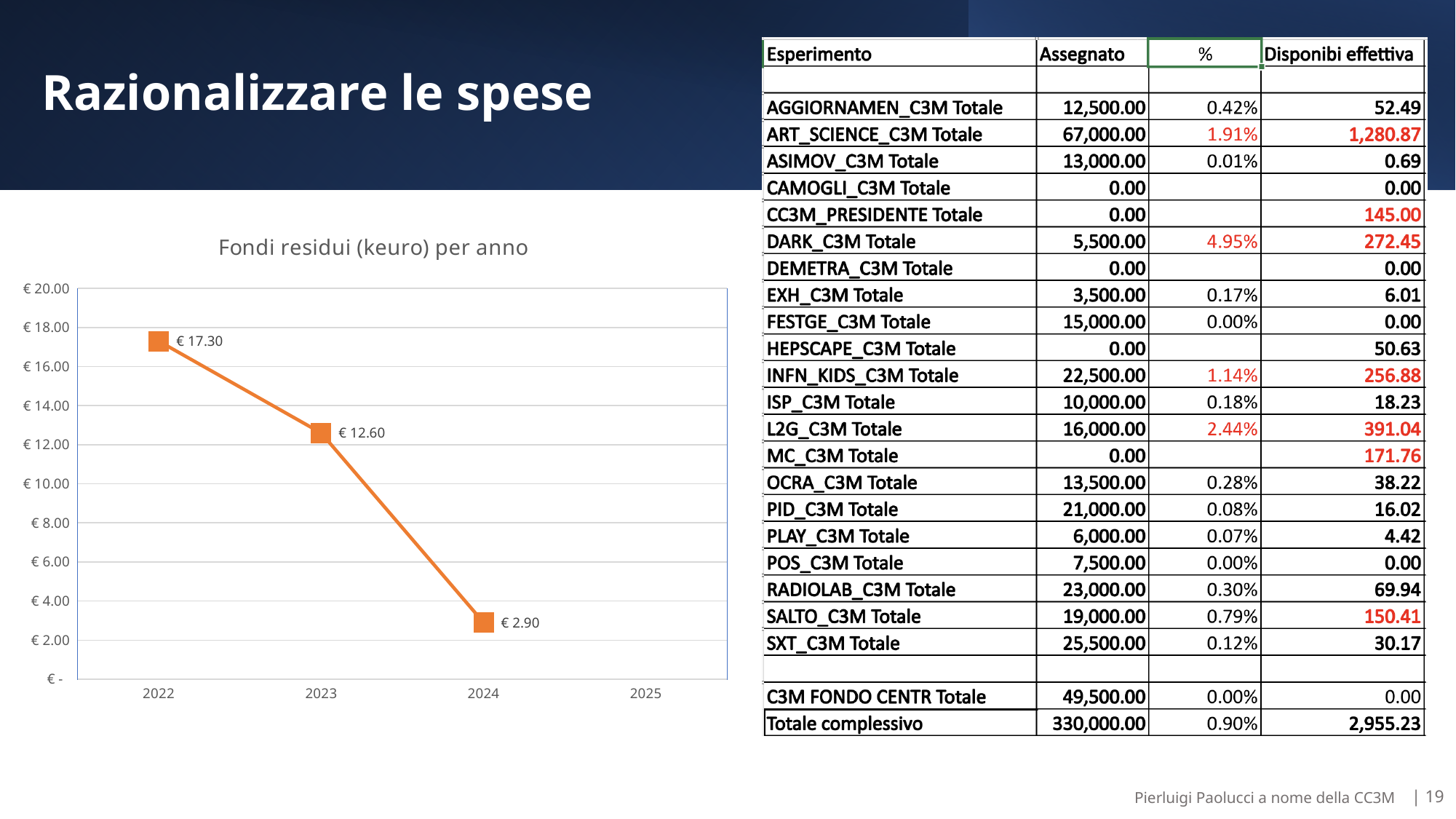
What is the difference between the values for 2023 and 2024 in the chart? € 9.70 Which year has the lowest value in the chart? 2024 Which is larger in the chart, the value for 2023 or the value for 2024? 2023 What is the value for 2023 in the chart? € 12.60 What is the title of the chart? Fondi residui (keuro) per anno What is the difference between the values for 2022 and 2023 in the chart? € 4.70 Which year has the highest value in the chart? 2022 Do the values in the chart rise or fall from 2022 to 2024? fall How many data points are plotted in the chart? 3 What type of chart is shown on the slide? line chart What is the value for 2024 in the chart? € 2.90 What is the value for 2022 in the chart? € 17.30